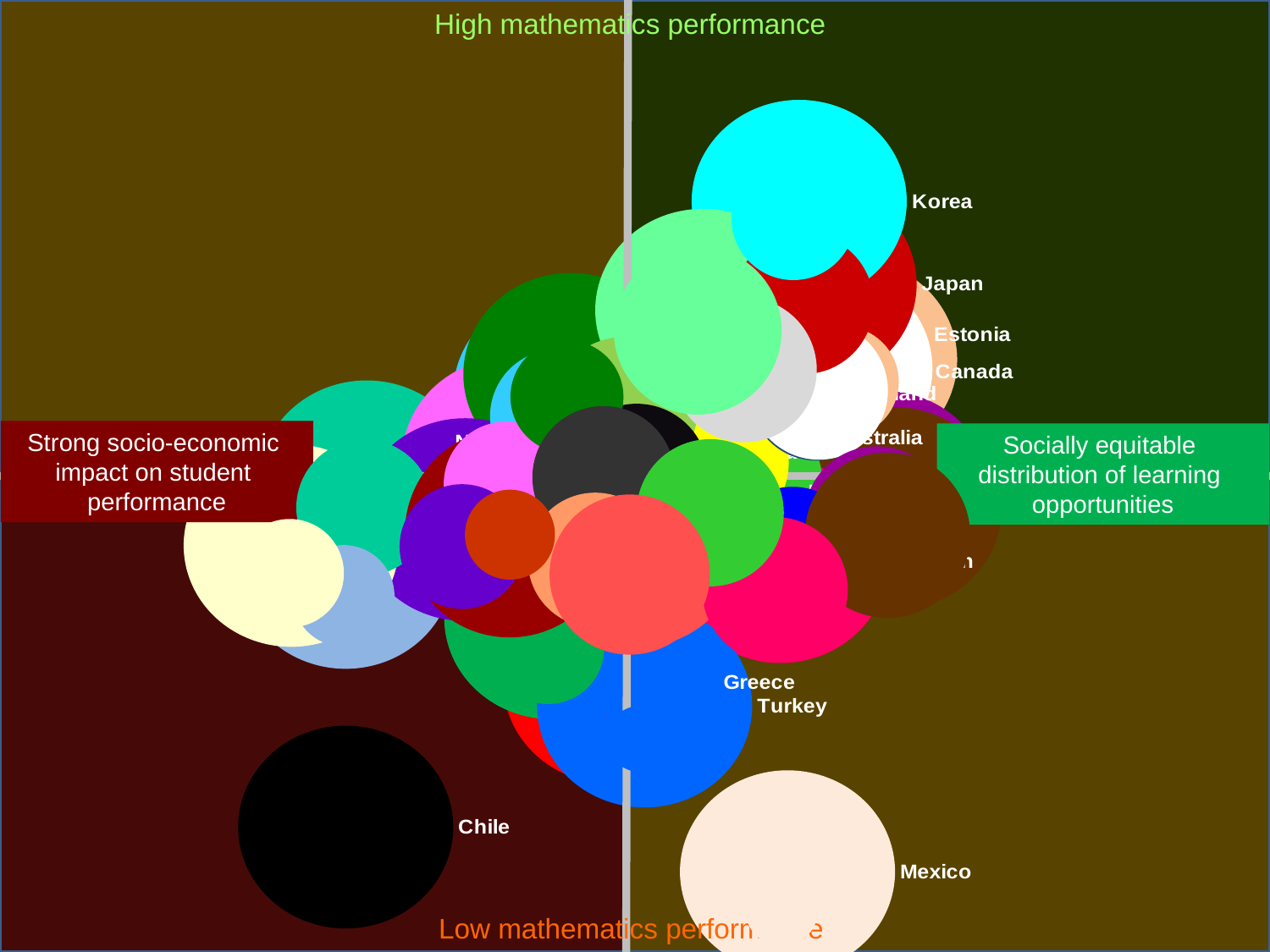
Which labelled country is plotted lowest on the chart (lowest mathematics performance)? Mexico Which is plotted higher on the chart, Japan or Greece? Japan Which is plotted further to the left, Chile or Mexico? Chile What does the label at the top of the chart say? High mathematics performance What does the label on the left side of the chart say? Strong socio-economic impact on student performance Which is plotted higher on the chart, Korea or Japan? Korea Which labelled country is plotted highest on the chart (highest mathematics performance)? Korea What kind of chart is shown on the slide? bubble chart